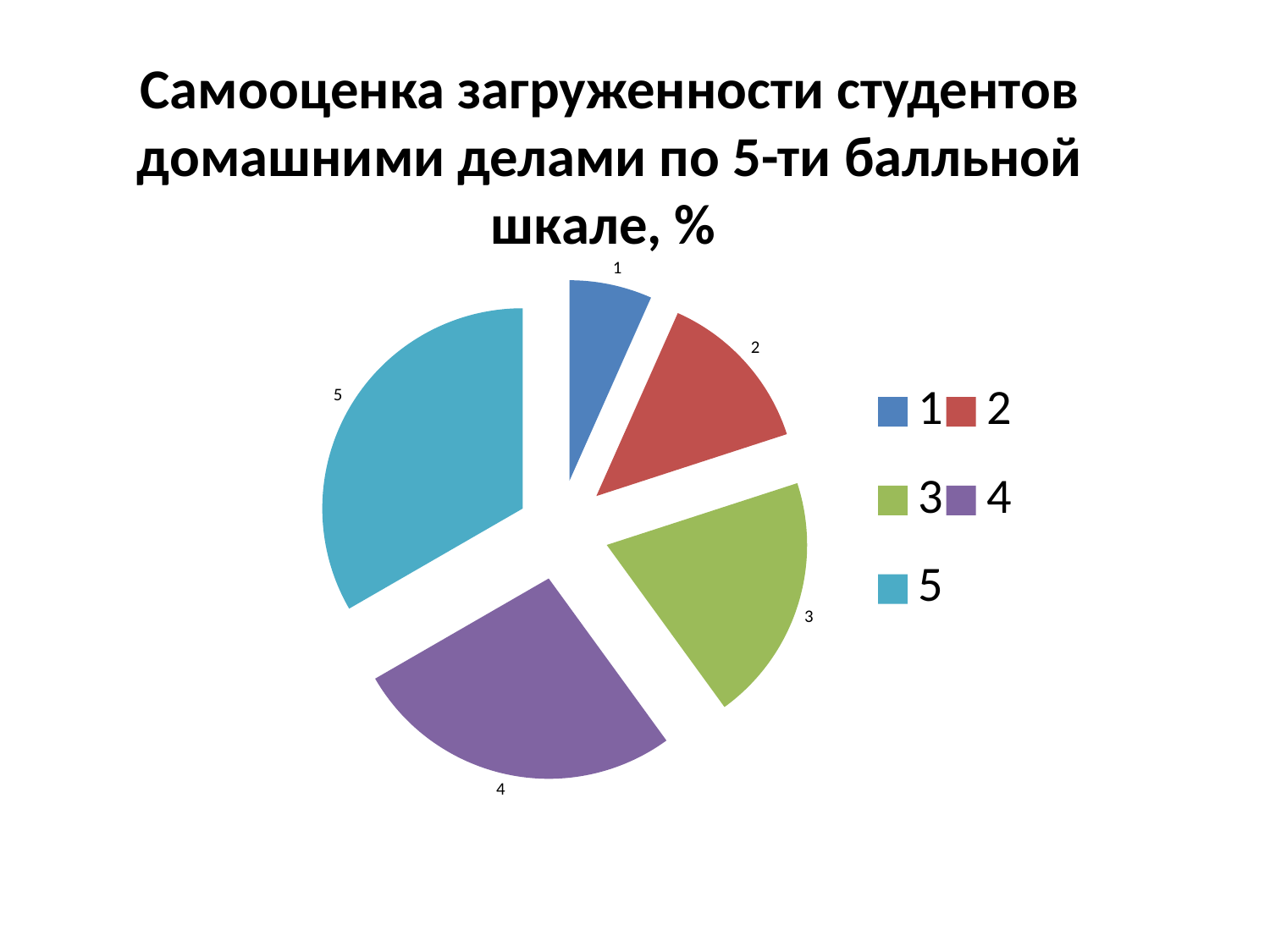
What kind of chart is shown on the slide? pie chart Which category has the largest slice of the pie? 5 What colour is the slice for category 4? purple What is the title of the chart? Самооценка загруженности студентов домашними делами по 5-ти балльной шкале, % Which slice is larger, category 2 or category 4? 4 How many entries does the legend list? 5 Which slice is larger, category 2 or category 1? 2 Which slice is larger, category 1 or category 3? 3 How many slices does the pie chart have? 5 Which category has the smallest slice of the pie? 1